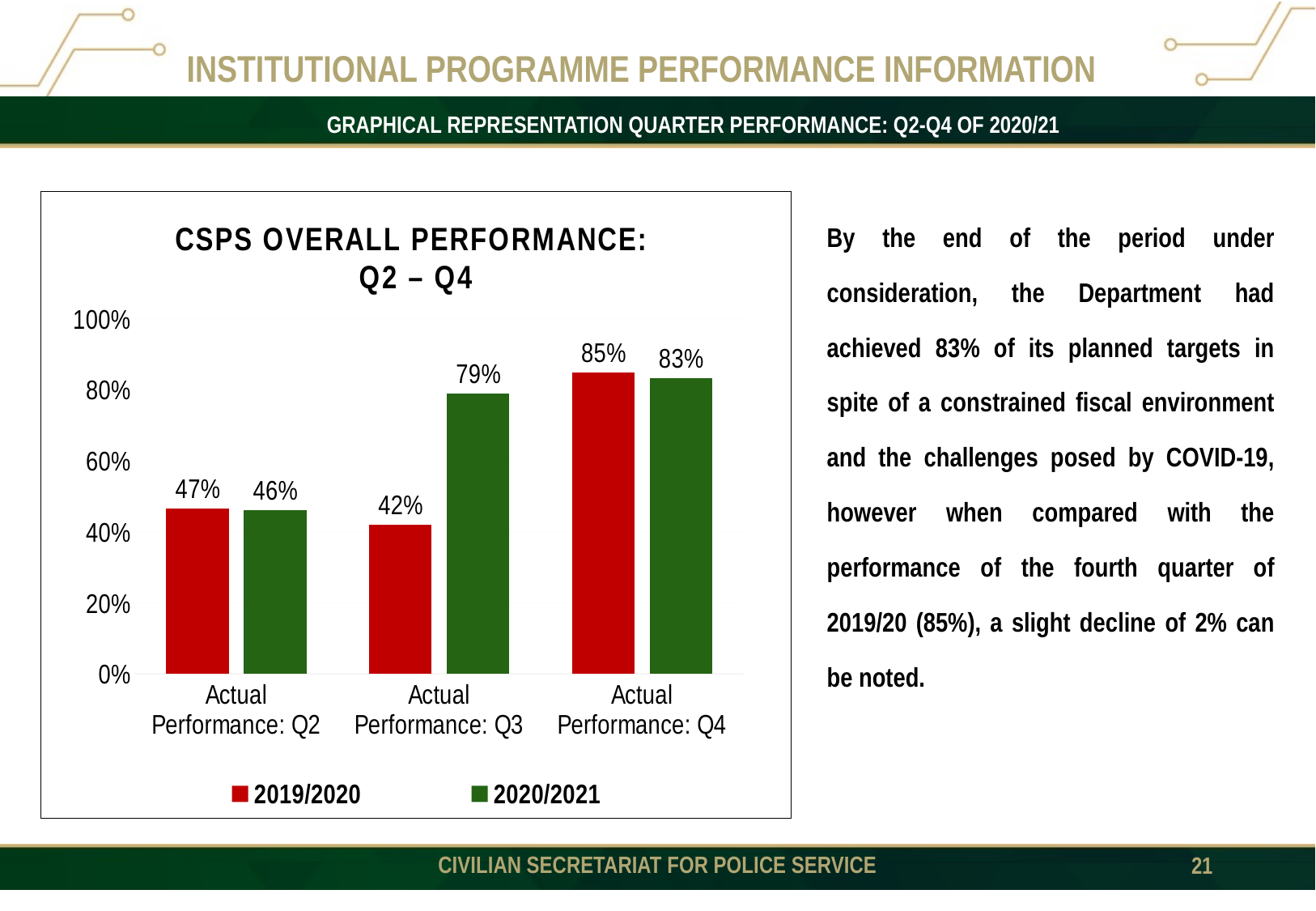
Do the 2020/2021 values rise or fall from Q2 to Q4? rise What is the 2020/2021 value for Actual Performance: Q2? 46% Which quarter has the lowest 2020/2021 value? Actual Performance: Q2 Which quarter has the highest 2019/2020 value? Actual Performance: Q4 Which is larger for Actual Performance: Q4, the 2019/2020 value or the 2020/2021 value? 2019/2020 What is the 2019/2020 value for Actual Performance: Q3? 42% What is the difference between the 2020/2021 and 2019/2020 values for Actual Performance: Q3? 37% What kind of chart is shown on the slide? bar chart What is the 2020/2021 value for Actual Performance: Q4? 83% How many categories are shown on the x axis? 3 How many series does the legend list? 2 Is the 2019/2020 value for Actual Performance: Q3 greater or less than 60%? less